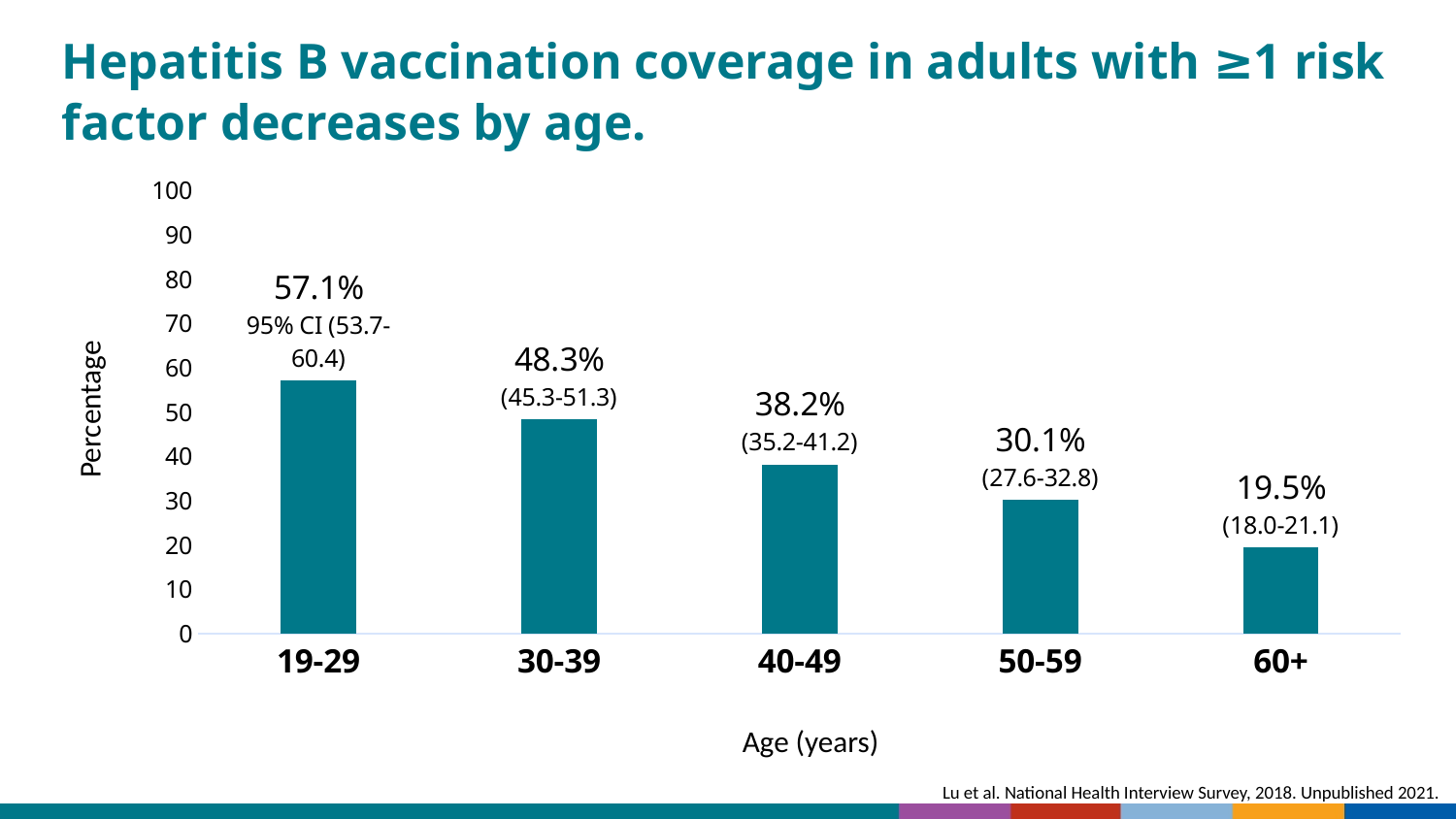
Do the vaccination coverage values rise or fall as age increases along the x axis? Fall Which age group has the highest vaccination coverage? 19-29 How many age groups are shown in the chart? 5 What kind of chart is shown on the slide? Bar chart What is the hepatitis B vaccination coverage for adults aged 19-29? 57.1% What is the difference in vaccination coverage between the 50-59 and 60+ age groups? 10.6 percentage points Which age group has higher vaccination coverage, 30-39 or 50-59? 30-39 What is the difference in vaccination coverage between the 19-29 and 30-39 age groups? 8.8 percentage points What is the vaccination coverage for the 40-49 age group? 38.2% Is the vaccination coverage for the 40-49 age group greater or less than 40? less Which age group has the lowest vaccination coverage? 60+ What is the vaccination coverage for adults aged 60+? 19.5%